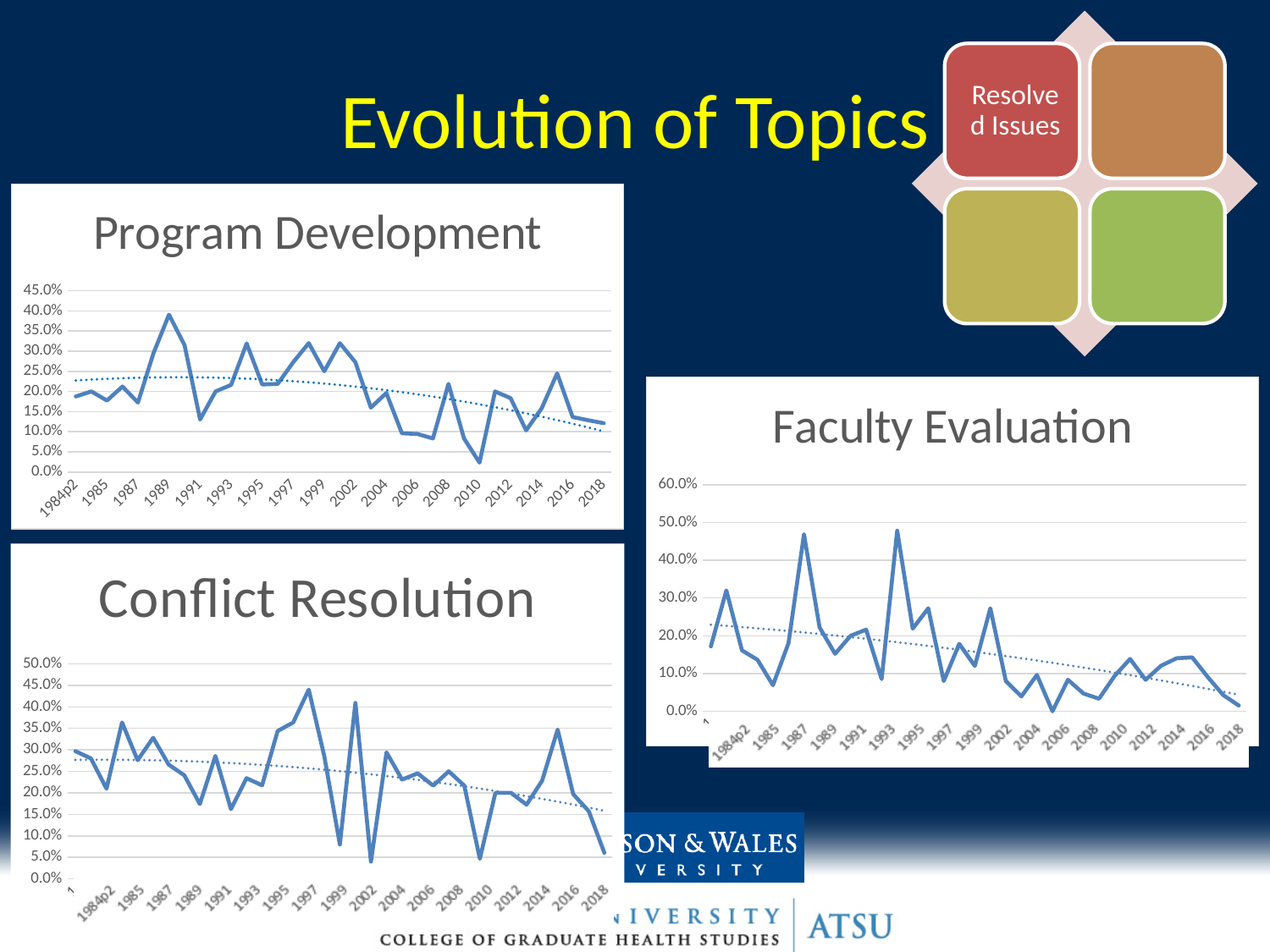
How many charts are shown on the slide? 3 In the Conflict Resolution chart, does the dotted trend line rise or fall from left to right? fall What kind of chart is the Faculty Evaluation chart? line chart In the Program Development chart, is the value for 2010 greater or less than 5.0%? less In the Faculty Evaluation chart, is the value for 2018 greater or less than 10.0%? less In the Conflict Resolution chart, which year has the highest value? 1997 In the Faculty Evaluation chart, is the value for 1987 greater or less than 40.0%? greater In the Program Development chart, which year has the lowest value? 2010 What kind of chart is the Program Development chart? line chart In the Program Development chart, which year has the highest value? 1989